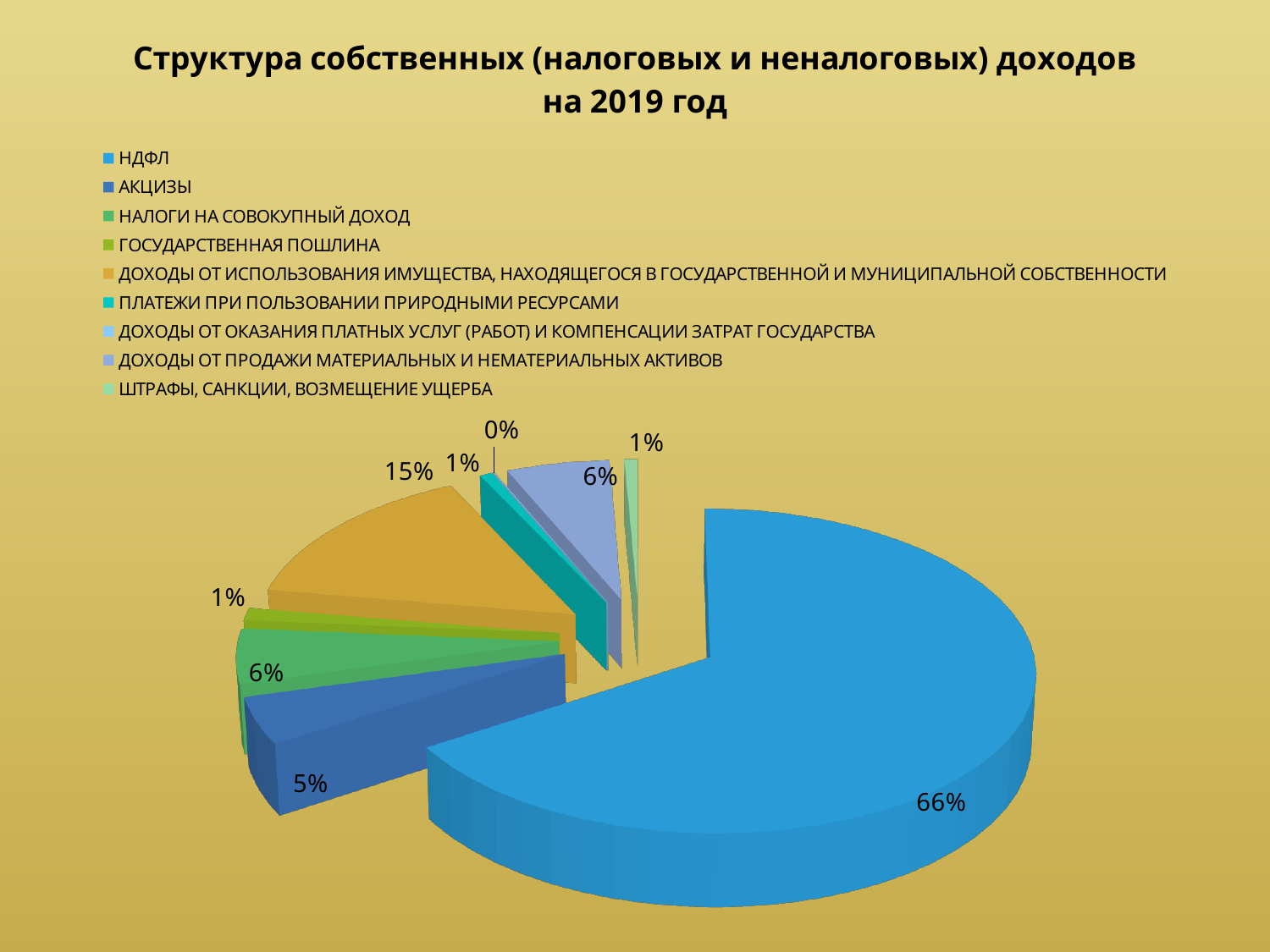
Which has a larger share: АКЦИЗЫ or НАЛОГИ НА СОВОКУПНЫЙ ДОХОД? НАЛОГИ НА СОВОКУПНЫЙ ДОХОД What kind of chart is shown on the slide? pie chart What percentage is shown for НАЛОГИ НА СОВОКУПНЫЙ ДОХОД? 6% What share of the pie does НДФЛ account for? 66% Which category has the largest share of the pie? НДФЛ What is the difference in percentage points between the share of НДФЛ and the share of ДОХОДЫ ОТ ИСПОЛЬЗОВАНИЯ ИМУЩЕСТВА? 51 What percentage is shown for ДОХОДЫ ОТ ИСПОЛЬЗОВАНИЯ ИМУЩЕСТВА, НАХОДЯЩЕГОСЯ В ГОСУДАРСТВЕННОЙ И МУНИЦИПАЛЬНОЙ СОБСТВЕННОСТИ? 15% What percentage is shown for ДОХОДЫ ОТ ОКАЗАНИЯ ПЛАТНЫХ УСЛУГ (РАБОТ) И КОМПЕНСАЦИИ ЗАТРАТ ГОСУДАРСТВА? 0% How many categories does the legend list? 9 What percentage is shown for АКЦИЗЫ? 5% What is the title of the chart? Структура собственных (налоговых и неналоговых) доходов на 2019 год Which category has the smallest share of the pie? ДОХОДЫ ОТ ОКАЗАНИЯ ПЛАТНЫХ УСЛУГ (РАБОТ) И КОМПЕНСАЦИИ ЗАТРАТ ГОСУДАРСТВА